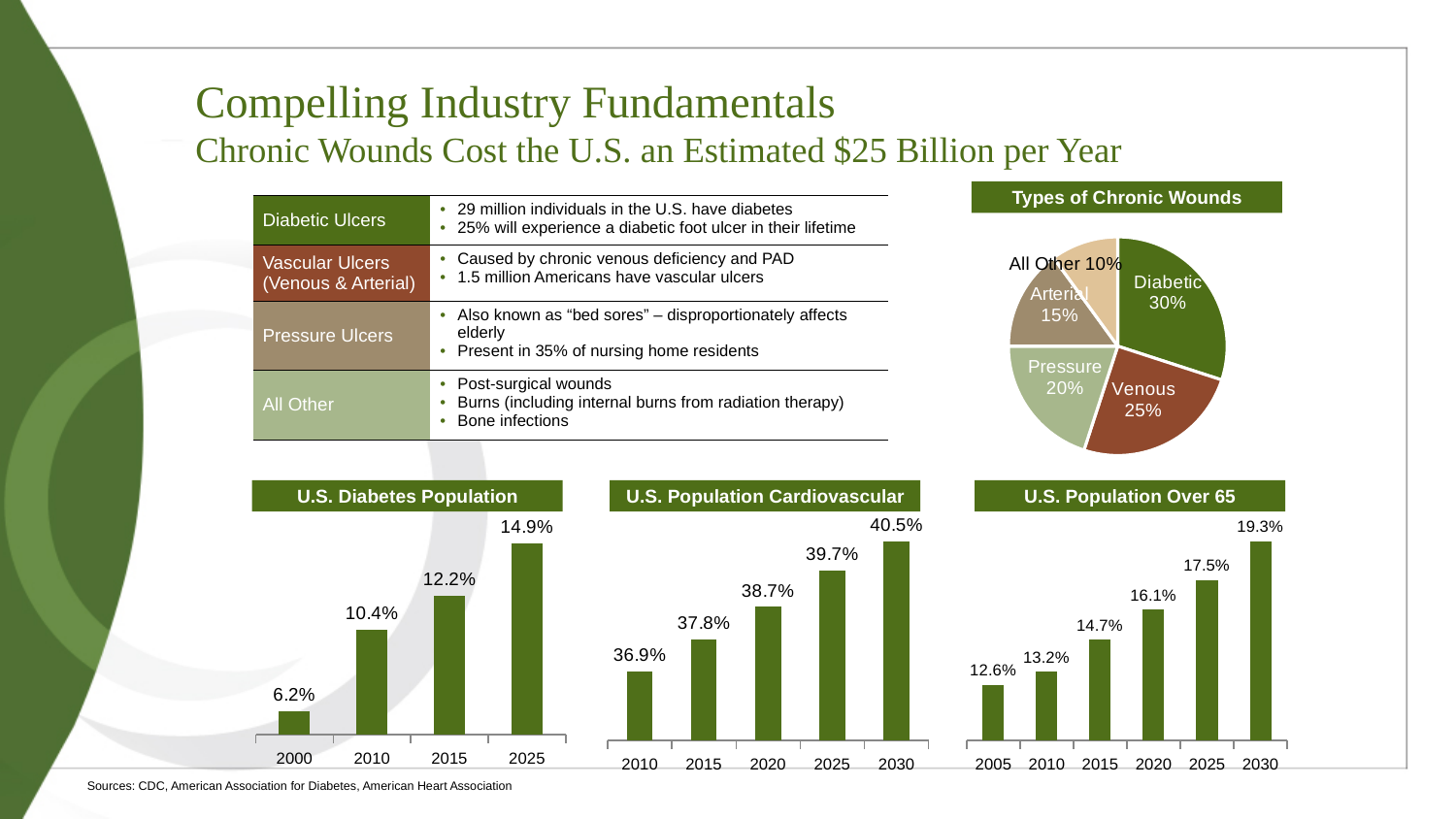
In the 'U.S. Population Cardiovascular' chart, what is the value for 2020? 38.7% In the 'Types of Chronic Wounds' pie chart, what is the difference between the Venous and Arterial shares? 10% In the 'U.S. Diabetes Population' chart, what is the difference between the 2025 and 2000 values? 8.7% In the 'Types of Chronic Wounds' pie chart, what share is Diabetic? 30% What kind of chart is 'U.S. Diabetes Population'? bar chart In the 'U.S. Population Over 65' chart, which is larger, the value for 2015 or the value for 2020? 2020 In the 'U.S. Population Over 65' chart, which year has the highest value? 2030 In the 'U.S. Population Cardiovascular' chart, do the values rise or fall from 2010 to 2030? rise In the 'U.S. Diabetes Population' chart, what is the value for 2015? 12.2% In the 'Types of Chronic Wounds' pie chart, how many slices are there? 5 In the 'U.S. Population Cardiovascular' chart, how many years are shown? 5 In the 'Types of Chronic Wounds' pie chart, which type has the smallest share? All Other